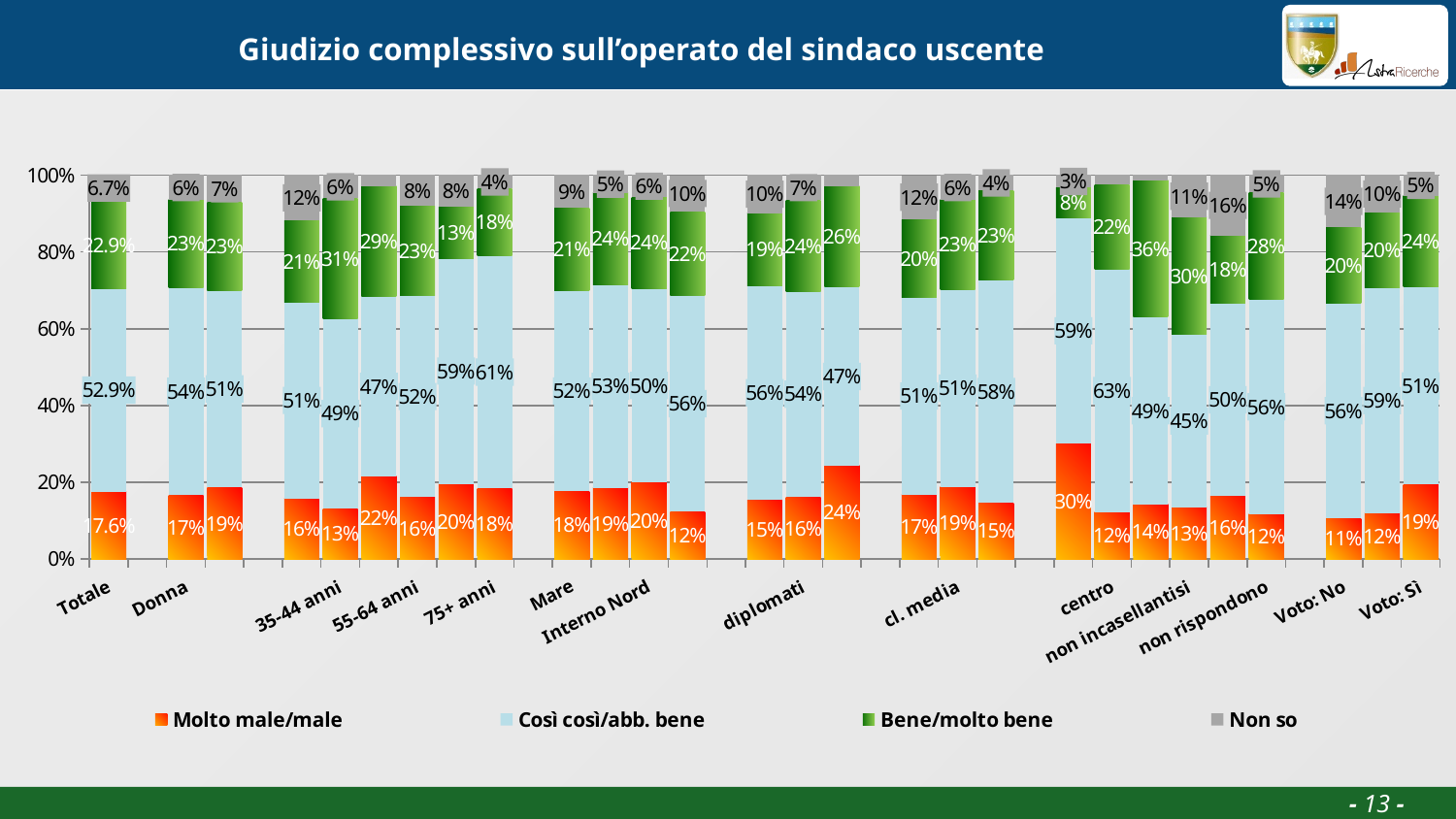
What is the 'Bene/molto bene' value for the 'Totale' bar? 22.9% In the 'Totale' bar, which is larger: the 'Così così/abb. bene' segment or the 'Bene/molto bene' segment? Così così/abb. bene What is the 'Molto male/male' value for the 'Totale' bar? 17.6% What is the title of the chart? Giudizio complessivo sull'operato del sindaco uscente How many series does the legend list? 4 What is the 'Così così/abb. bene' value for the '75+ anni' bar? 61% What is the 'Bene/molto bene' value for the 'non rispondono' bar? 28% What is the 'Così così/abb. bene' value for the 'Totale' bar? 52.9% In the 'Totale' bar, what is the difference between the 'Bene/molto bene' value and the 'Non so' value? 16.2 percentage points What is the 'Non so' value for the 'Totale' bar? 6.7% What is the 'Molto male/male' value for the 'Voto: Sì' bar? 19% What kind of chart is shown on the slide? Stacked bar chart